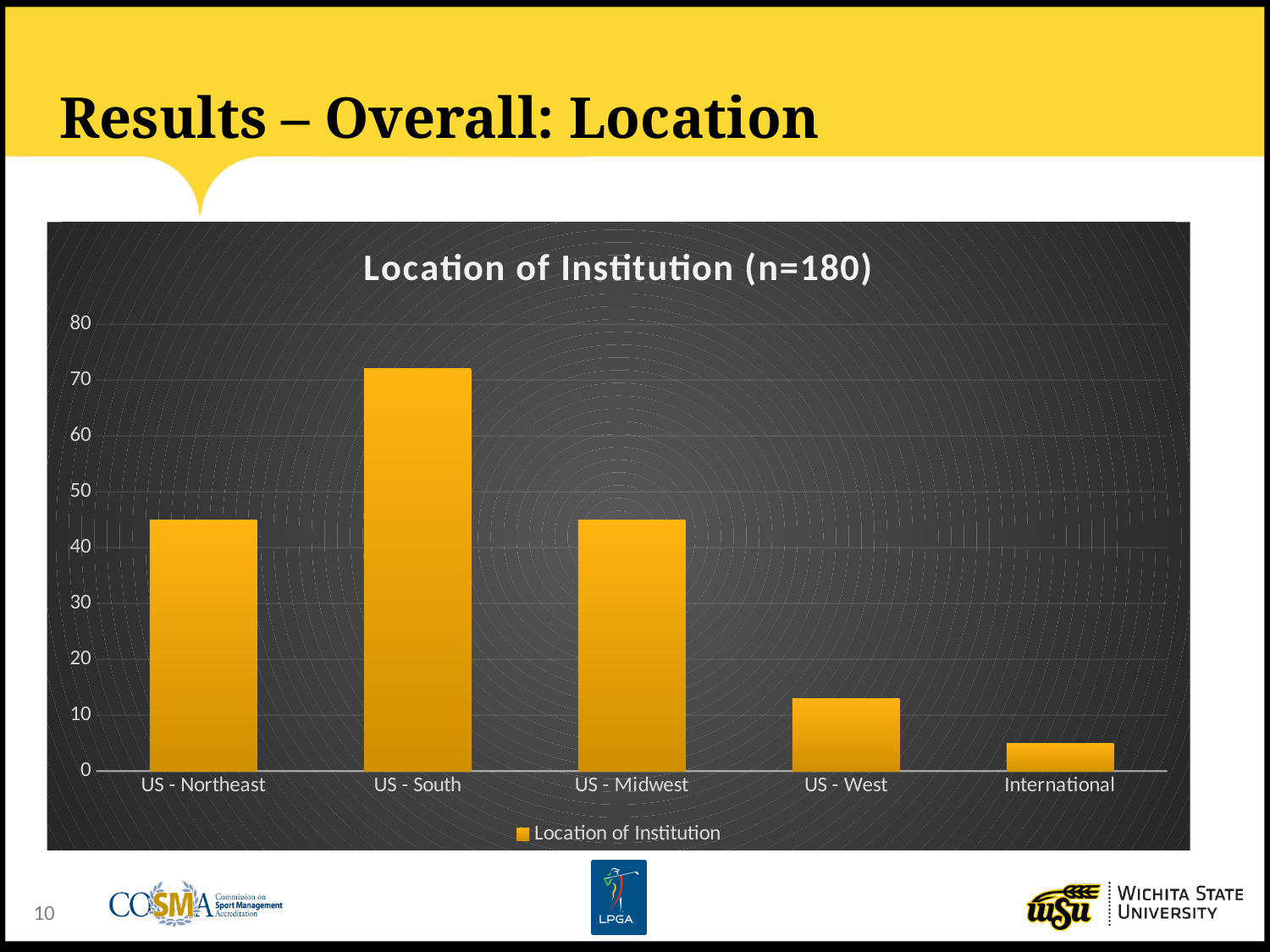
Which location has the highest bar? US - South What is the legend entry shown below the chart? Location of Institution How many location categories are shown on the x axis? 5 Which location has the lowest bar? International Which is larger, the value for US - Midwest or the value for US - West? US - Midwest Is the value for International greater or less than 10? less Is the value for US - South greater or less than 70? greater What is the title of the chart? Location of Institution (n=180) Is the value for US - Northeast greater or less than 40? greater How many series does the legend list? 1 What kind of chart is shown on the slide? bar chart